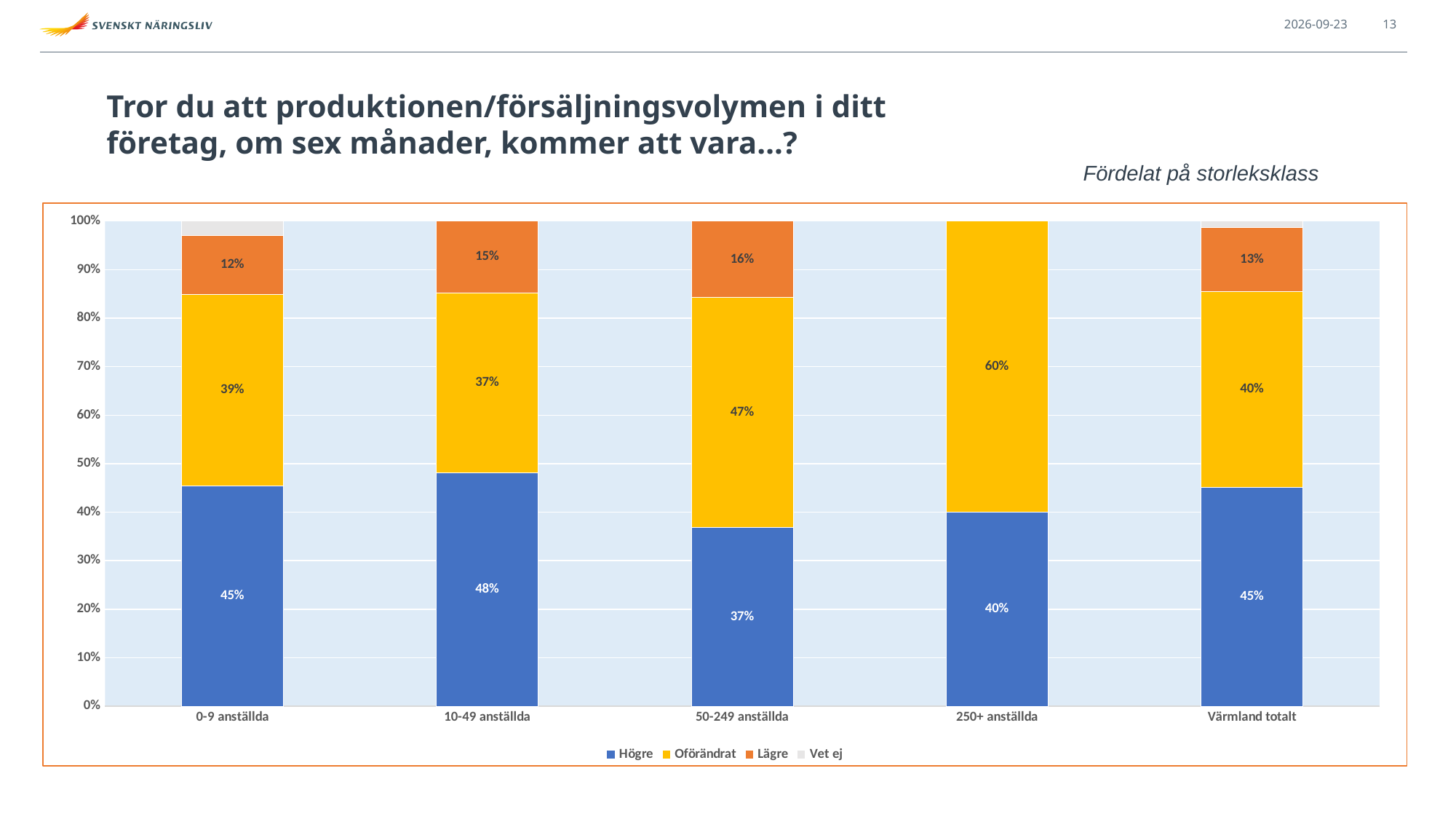
Which category has the highest Oförändrat share? 250+ anställda What is the Högre share for 10-49 anställda? 48% Which colour represents the Lägre series in the legend? Orange How many size-class categories are shown on the x axis? 5 How many series does the legend list? 4 What is the difference in Högre share between 10-49 anställda and 50-249 anställda? 11 percentage points What is the Oförändrat share for Värmland totalt? 40% Which category has the lowest Högre share? 50-249 anställda What is the Lägre share for 50-249 anställda? 16% What kind of chart is shown on the slide? Stacked bar chart Which is larger: the Lägre share for 0-9 anställda or for 10-49 anställda? 10-49 anställda What is the Oförändrat share for 250+ anställda? 60%